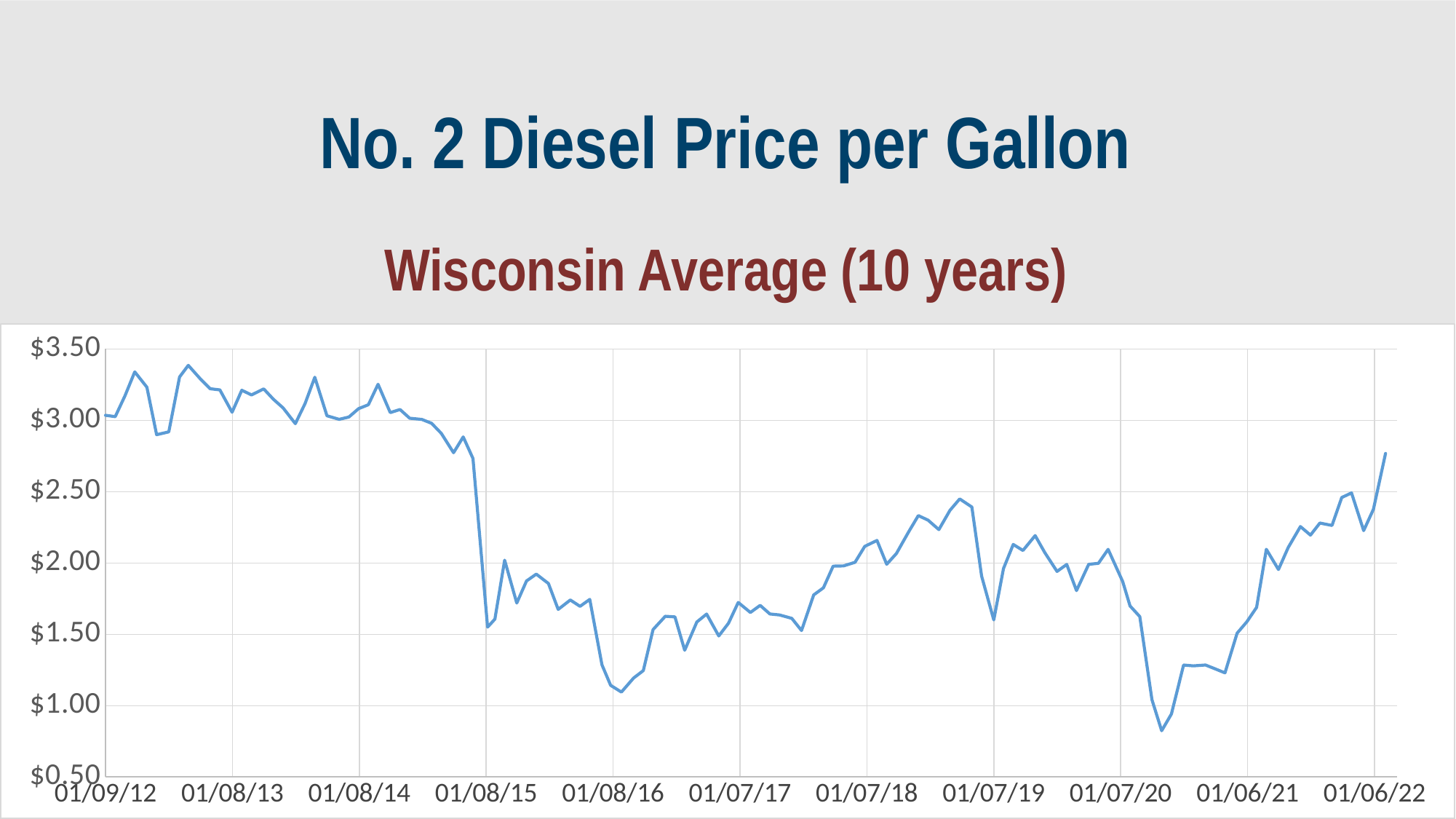
Is the diesel price at 01/07/19 greater or less than $2.00? less What is the title of the chart on the slide? No. 2 Diesel Price per Gallon Does the diesel price rise or fall between 01/07/20 and 01/06/22? rise Which date has the higher diesel price, 01/07/20 or 01/06/22? 01/06/22 What kind of chart is shown on the slide? line chart Is the diesel price at 01/07/20 greater or less than $1.00? greater Is the diesel price at 01/06/21 greater or less than $2.00? less Which date has the higher diesel price, 01/08/13 or 01/08/16? 01/08/13 What subtitle appears below the chart title? Wisconsin Average (10 years) How many date labels are shown on the x axis? 11